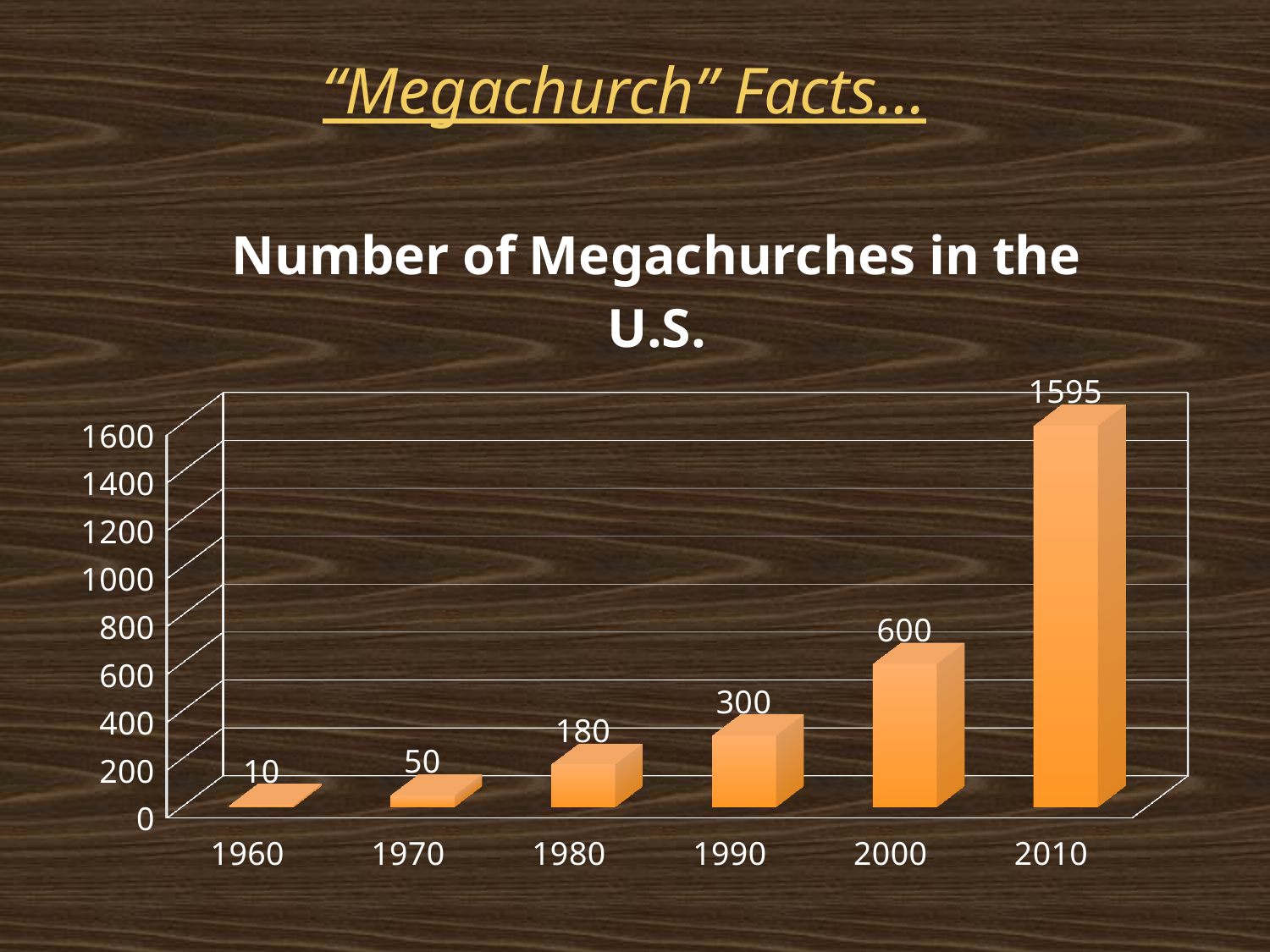
What is the title of the chart? Number of Megachurches in the U.S. What is the number of megachurches in the U.S. in 2010? 1595 What is the difference between the number of megachurches in 1980 and in 1970? 130 What kind of chart is shown on the slide? Bar chart What is the number of megachurches in the U.S. in 1990? 300 Which year has the lowest number of megachurches? 1960 Which year has the highest number of megachurches? 2010 Which year has more megachurches, 1990 or 2000? 2000 What is the number of megachurches in the U.S. in 1960? 10 What is the difference between the number of megachurches in 2010 and in 2000? 995 How many years are shown on the x axis of the chart? 6 Do the values rise or fall from 1960 to 2010? Rise